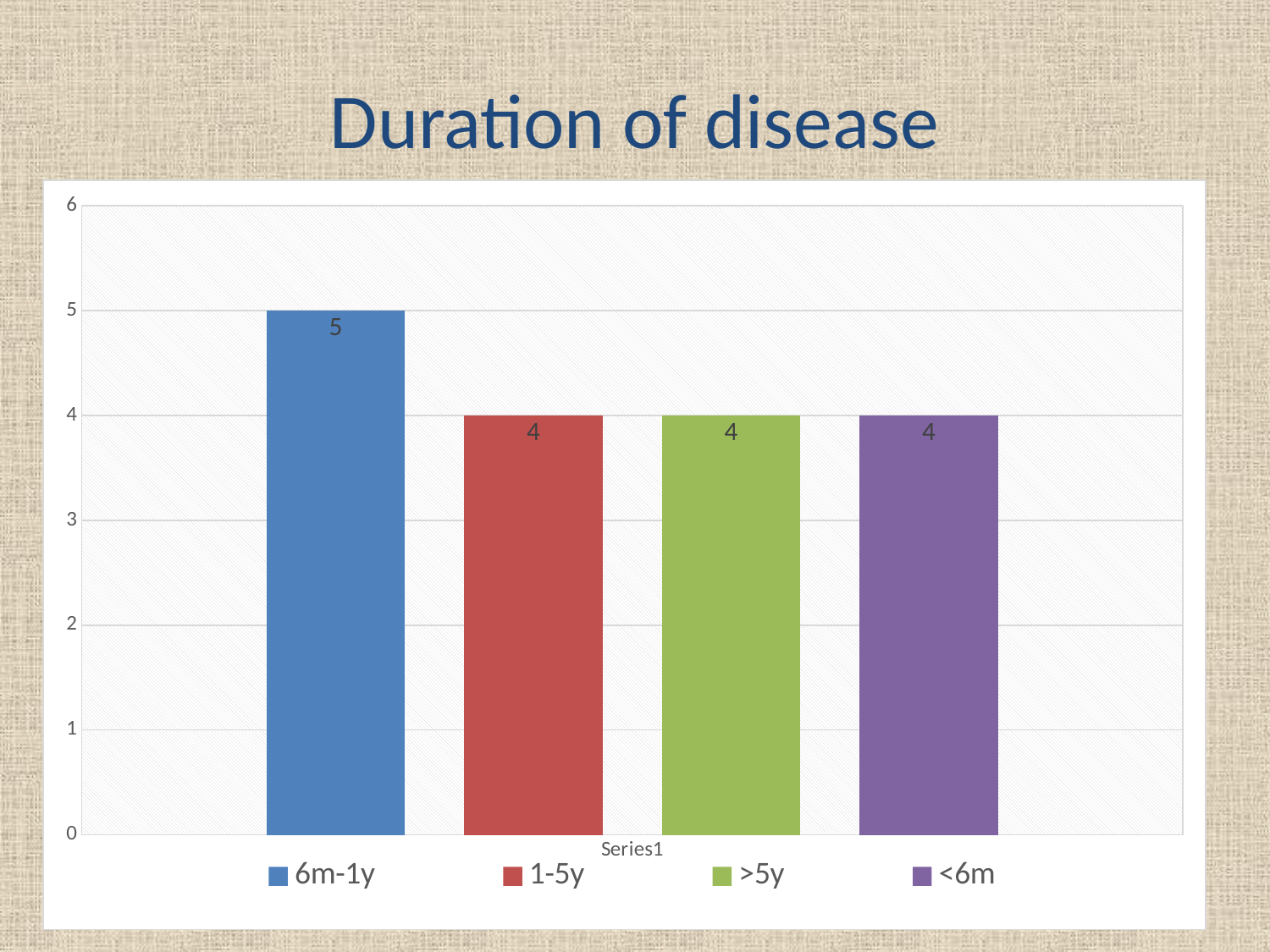
Is the value for 6m-1y greater or less than 4? greater What is the value for <6m? 4 What is the difference between the values for 6m-1y and 1-5y? 1 What is the value for >5y? 4 What colour is the bar for >5y? green How many categories does the legend list? 4 What is the value for 6m-1y? 5 Which is larger, the value for 6m-1y or the value for <6m? 6m-1y What is the title of the slide? Duration of disease What kind of chart is shown on the slide? bar chart Which category has the highest value? 6m-1y What is the value for 1-5y? 4